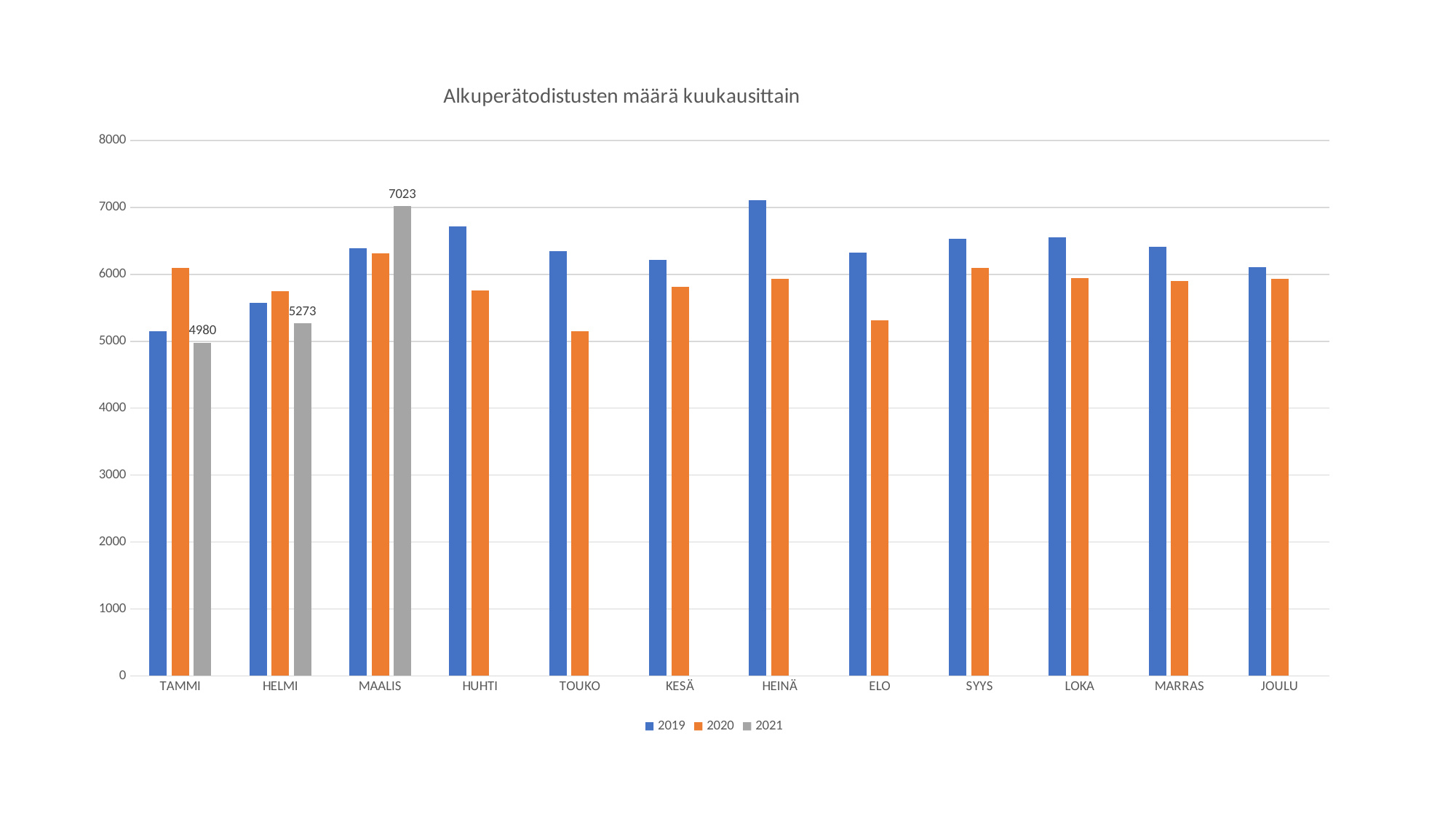
What is the value for 2021 in MAALIS? 7023 What is the value for 2021 in HELMI? 5273 How many months are shown on the x axis? 12 Which month has the highest value for the 2019 series? HEINÄ What is the difference between the 2021 values for MAALIS and TAMMI? 2043 Is the value for 2020 in ELO greater or less than 6000? less In TAMMI, which is larger: the 2019 value or the 2020 value? 2020 What is the difference between the 2021 values for HELMI and TAMMI? 293 Is the value for 2019 in HEINÄ greater or less than 7000? greater Which month has the highest value for the 2021 series? MAALIS What is the value for 2021 in TAMMI? 4980 How many series does the legend list? 3